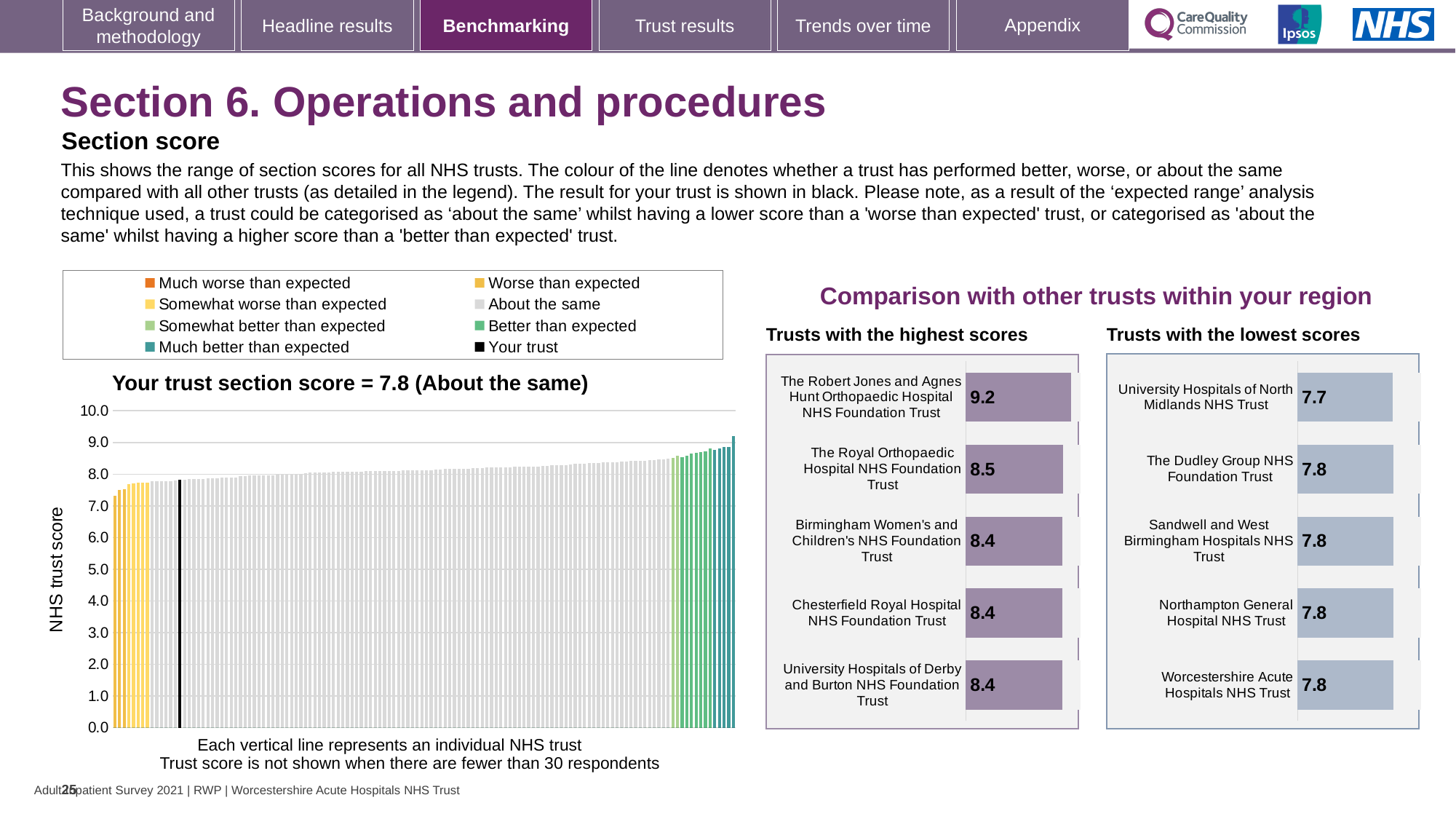
In the 'Trusts with the highest scores' chart, which trust has the highest score? The Robert Jones and Agnes Hunt Orthopaedic Hospital NHS Foundation Trust In the 'Trusts with the highest scores' chart, what is the score for The Robert Jones and Agnes Hunt Orthopaedic Hospital NHS Foundation Trust? 9.2 In the 'Trusts with the highest scores' chart, what is the difference between the scores of The Robert Jones and Agnes Hunt Orthopaedic Hospital NHS Foundation Trust and The Royal Orthopaedic Hospital NHS Foundation Trust? 0.7 What kind of chart is the 'Your trust section score' chart? bar chart In the 'Your trust section score' chart, what category is your trust placed in? About the same How many trusts are listed in the 'Trusts with the lowest scores' chart? 5 In the 'Your trust section score' chart, is the value of the leftmost (lowest) bar greater or less than 8.0? less In the 'Trusts with the lowest scores' chart, which trust has the lowest score? University Hospitals of North Midlands NHS Trust In the 'Trusts with the lowest scores' chart, what is the score for Worcestershire Acute Hospitals NHS Trust? 7.8 In the 'Your trust section score' bar chart, what is the section score for your trust? 7.8 In the 'Your trust section score' chart, do the bar values rise or fall from left to right? rise What is the label on the vertical axis of the 'Your trust section score' chart? NHS trust score